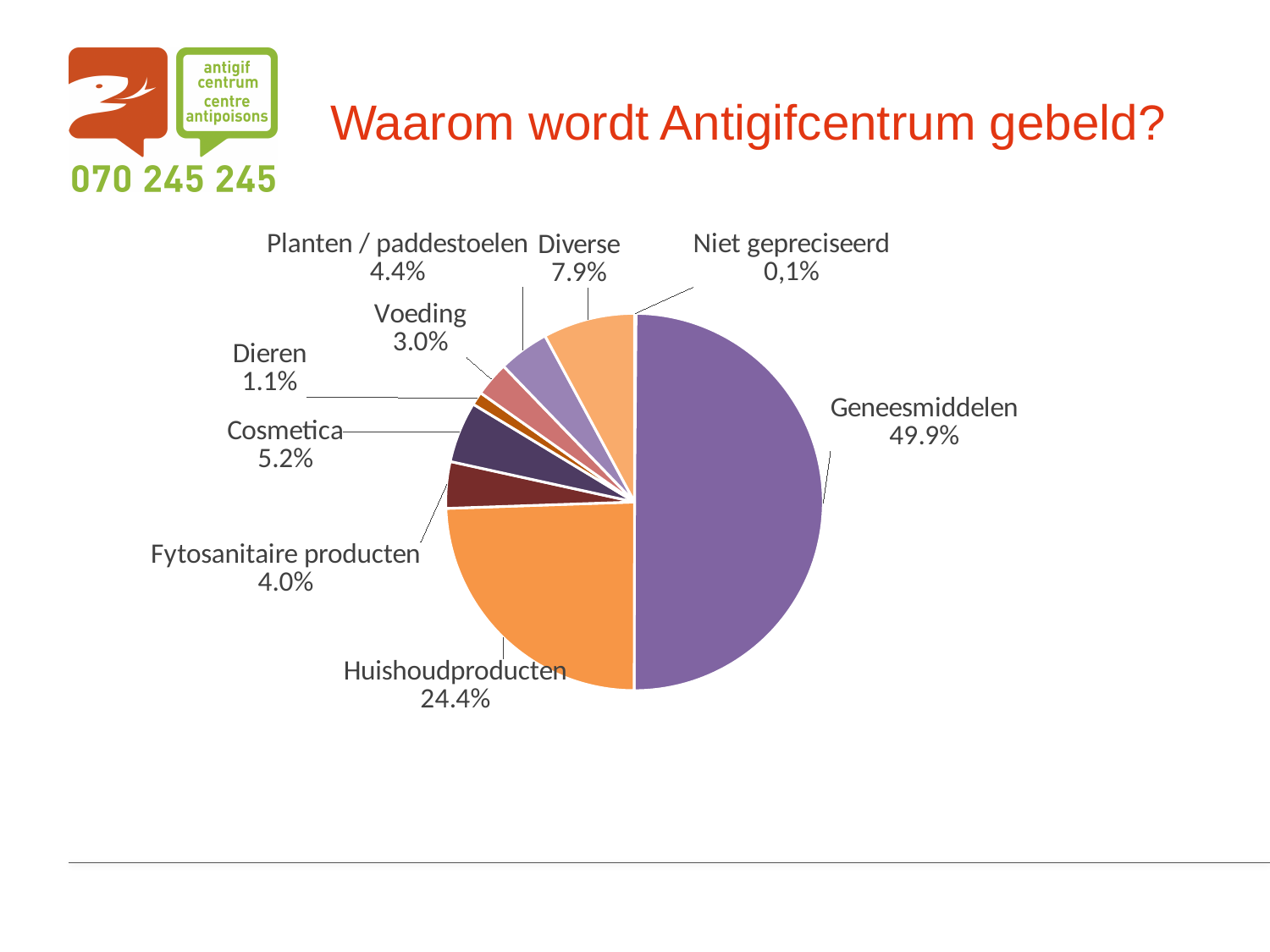
What is the difference in percentage points between Geneesmiddelen and Huishoudproducten? 25.5 What percentage is shown for Niet gepreciseerd? 0,1% What type of chart is shown on the slide? pie chart Which category has the smallest slice of the pie? Niet gepreciseerd What share of the pie does Geneesmiddelen have? 49.9% How many categories are shown in the pie chart? 9 What percentage is shown for Planten / paddestoelen? 4.4% What percentage is shown for Huishoudproducten? 24.4% What percentage is shown for Cosmetica? 5.2% What is the title of the slide containing the chart? Waarom wordt Antigifcentrum gebeld? Which is larger, the share for Diverse or the share for Cosmetica? Diverse Which category has the largest slice of the pie? Geneesmiddelen